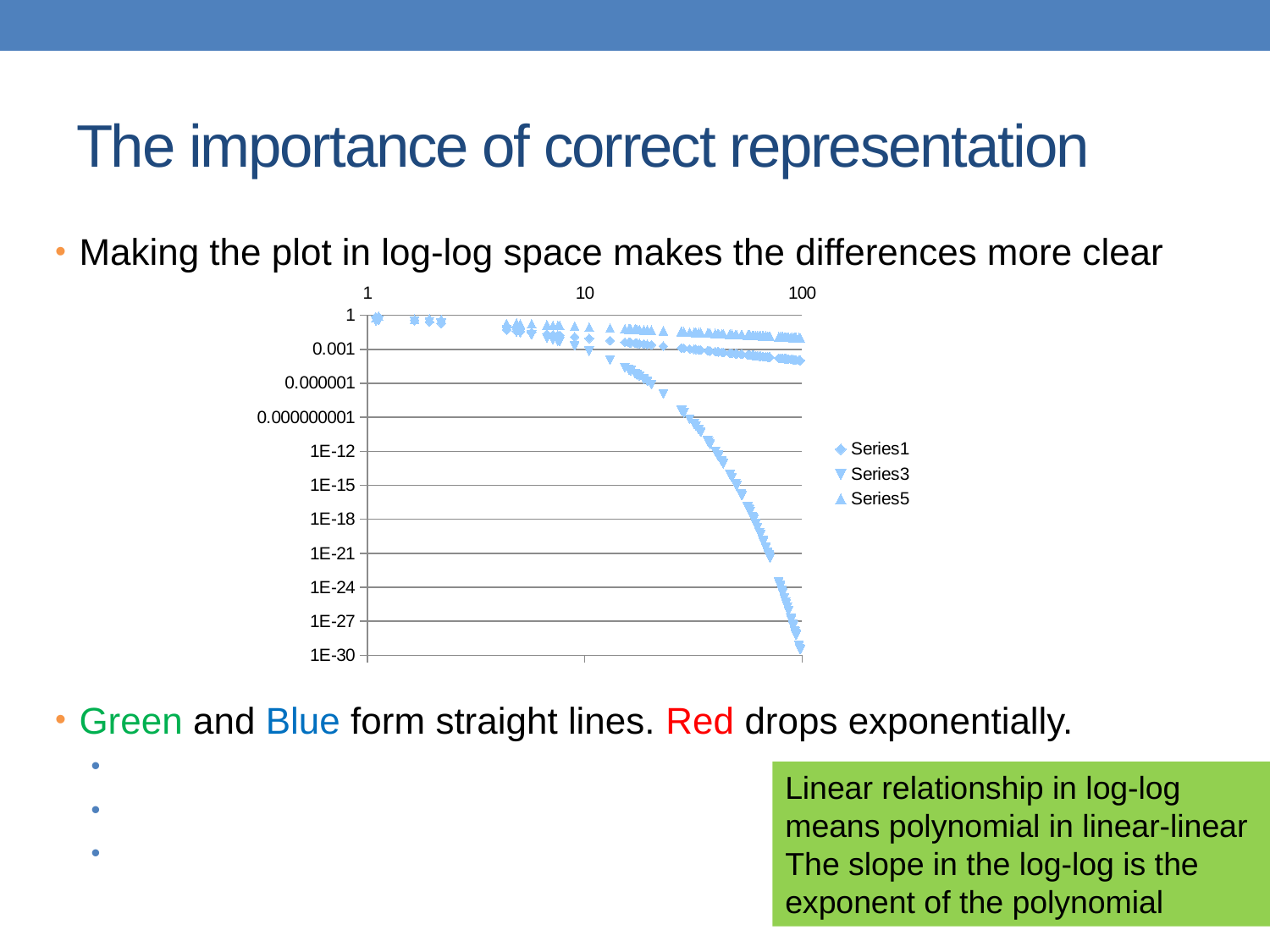
What is the lowest tick label shown on the chart's vertical axis? 1E-30 How many series does the chart legend list? 3 Near x = 100, is the value for Series1 greater or less than 0.000001? greater Near x = 100, which series has larger values, Series1 or Series3? Series1 Which series has the highest values near x = 100? Series5 What kind of chart is shown on the slide? scatter chart Which series has the lowest values near x = 100? Series3 Near x = 100, is the value for Series5 greater or less than 0.001? greater Which series are listed in the chart legend? Series1, Series3, Series5 Do the values of Series3 rise or fall as x increases toward 100? fall How many tick labels are shown on the chart's horizontal axis? 3 Near x = 100, is the value for Series3 greater or less than 1E-21? less